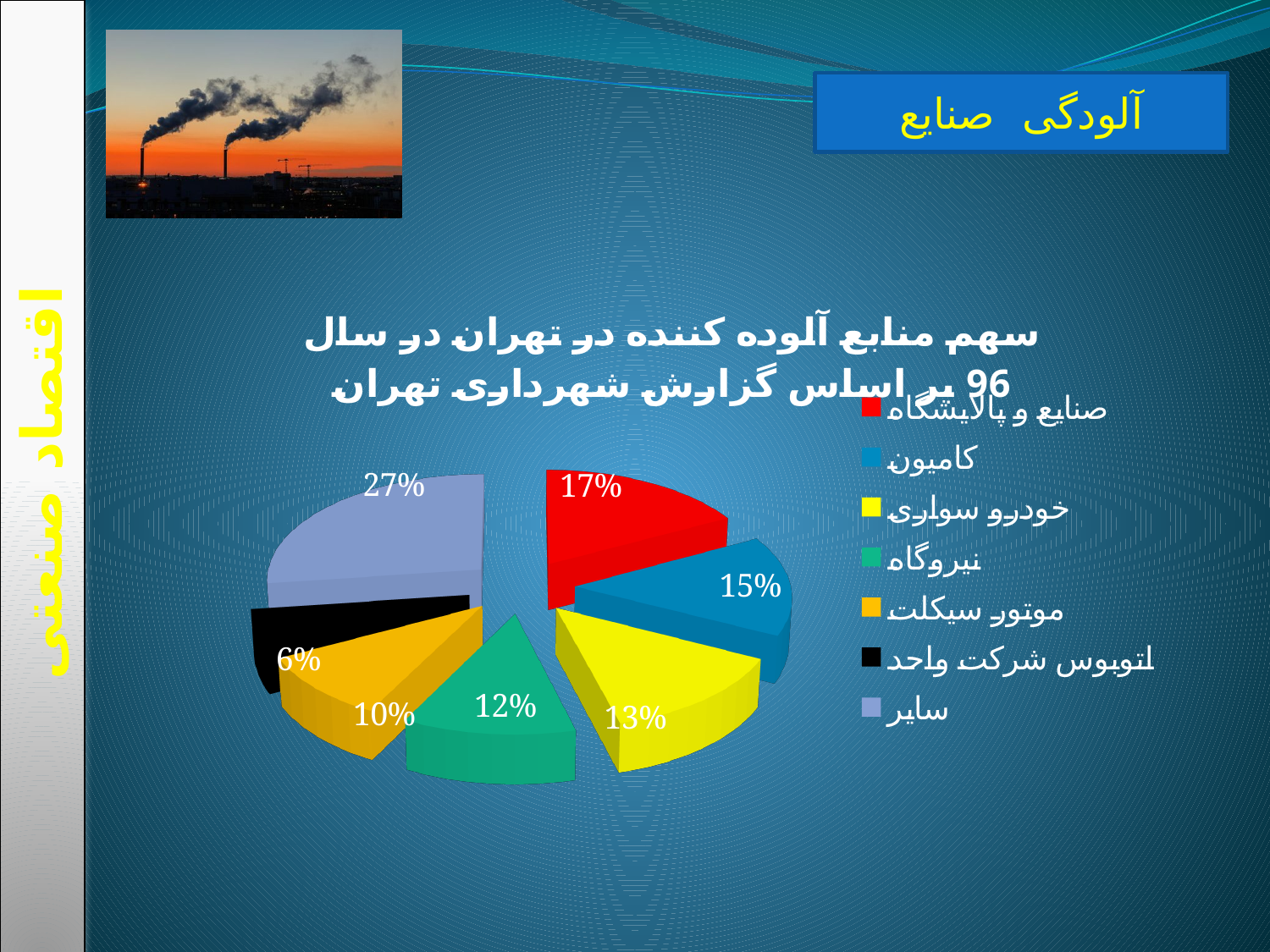
How many categories does the legend list? 7 What kind of chart is shown on the slide? pie chart What share of the pie does اتوبوس شرکت واحد have? 6% What share of the pie does صنایع و پالایشگاه have? 17% Which category has the largest slice of the pie? سایر What share of the pie does کامیون have? 15% Which has a larger share, کامیون or نیروگاه? کامیون What is the difference between the shares of سایر and صنایع و پالایشگاه? 10% What share of the pie does خودرو سواری have? 13% What share of the pie does موتور سیکلت have? 10% What share of the pie does نیروگاه have? 12% Which category has the smallest slice of the pie? اتوبوس شرکت واحد